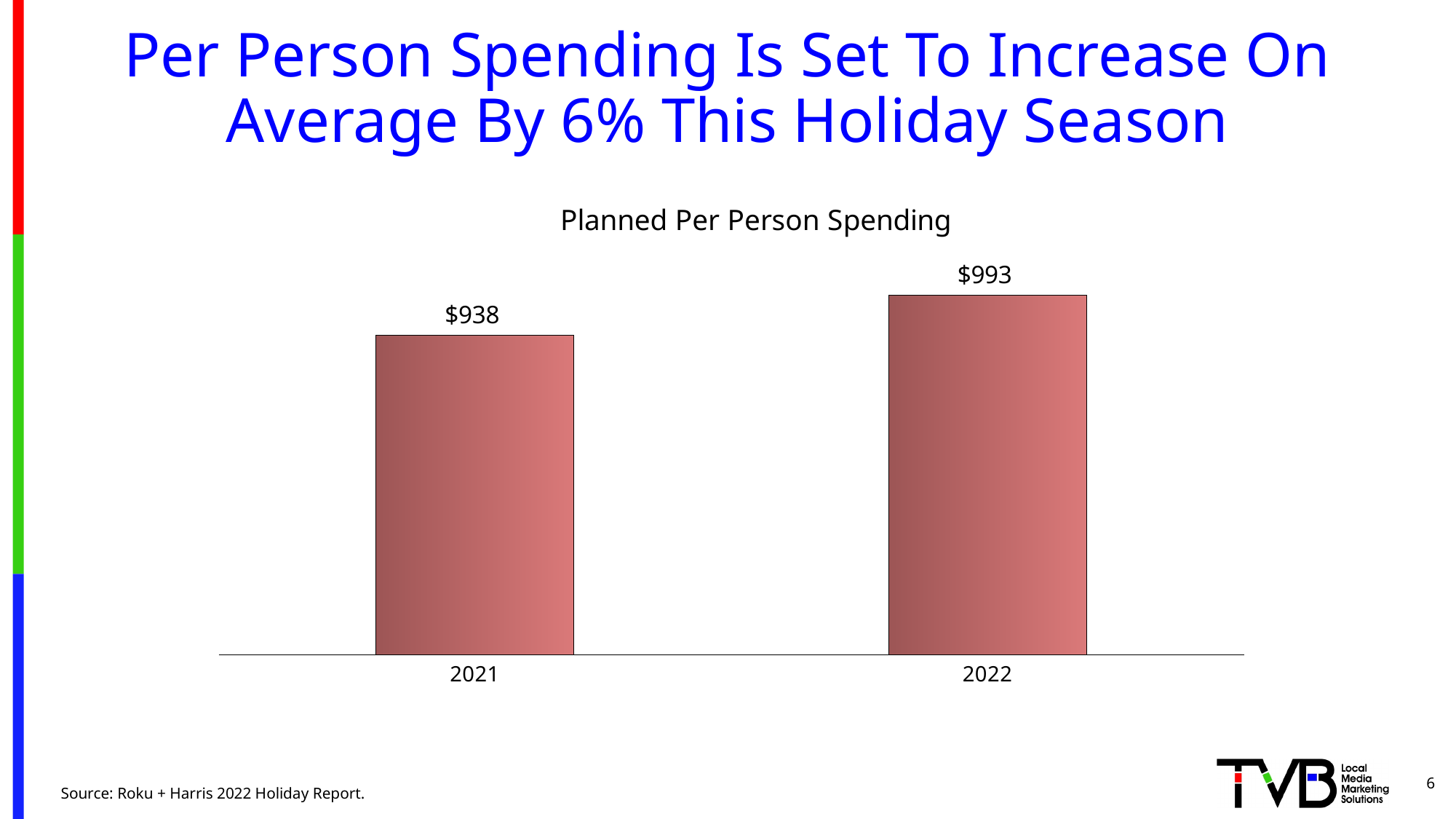
What is the planned per person spending for 2022? $993 Which year has the higher planned per person spending? 2022 What is the planned per person spending for 2021? $938 Which year has the lower planned per person spending? 2021 What is the title of the chart? Planned Per Person Spending By how much does planned per person spending in 2022 exceed that of 2021? $55 What type of chart is used to show planned per person spending? Bar chart How many years are shown on the chart? 2 What is the source cited for the chart data? Roku + Harris 2022 Holiday Report Does planned per person spending rise or fall from 2021 to 2022? Rise Is the planned per person spending larger in 2021 or 2022? 2022